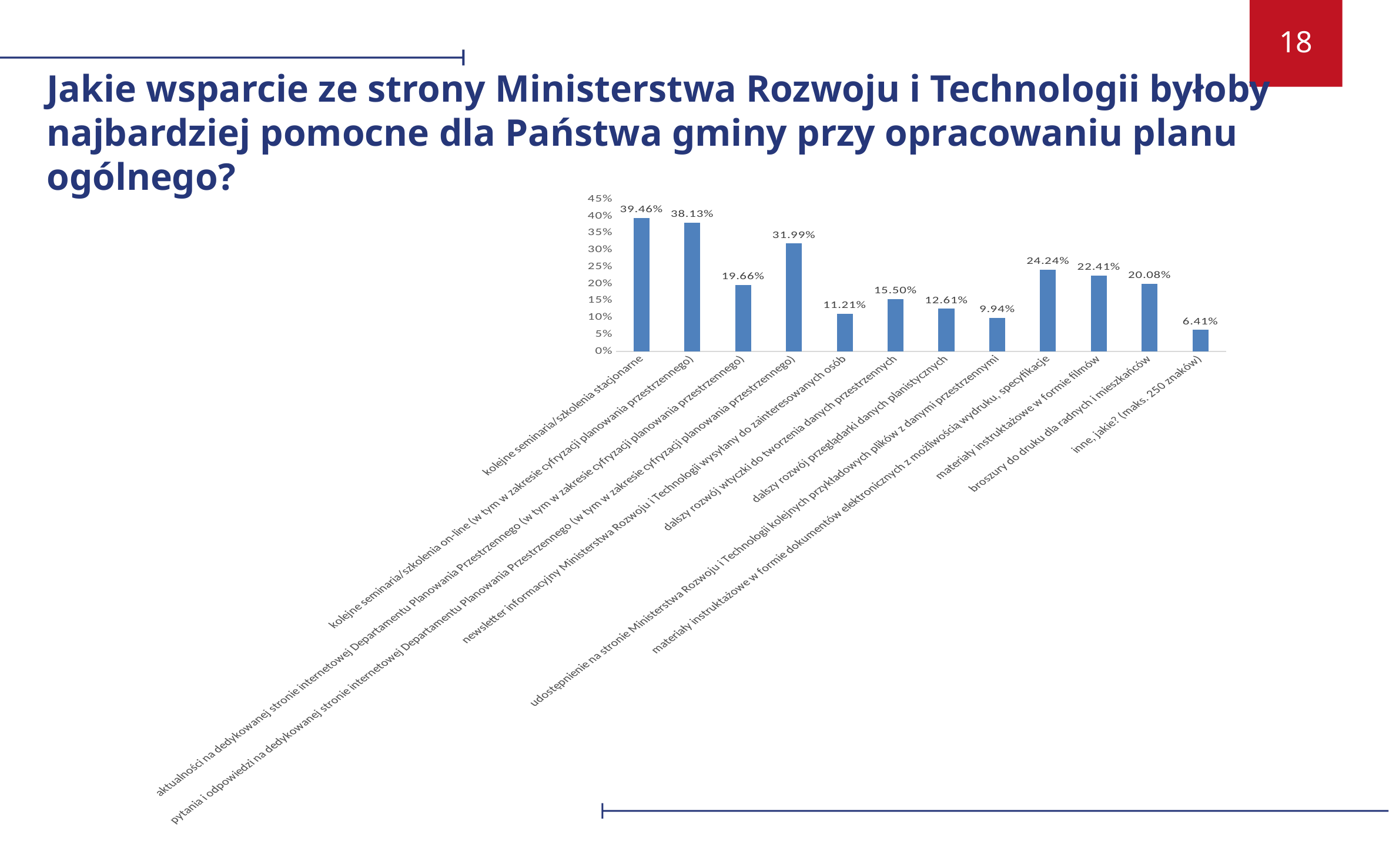
Is the value for 'newsletter informacyjny Ministerstwa Rozwoju i Technologii wysyłany do zainteresowanych osób' greater or less than 15%? less What value is shown for 'broszury do druku dla radnych i mieszkańców'? 20.08% Which is larger: the value for 'materiały instruktażowe w formie filmów' or for 'dalszy rozwój przeglądarki danych planistycznych'? materiały instruktażowe w formie filmów What percentage is shown for 'dalszy rozwój wtyczki do tworzenia danych przestrzennych'? 15.50% What percentage is shown for 'kolejne seminaria/szkolenia stacjonarne'? 39.46% What value is shown for 'materiały instruktażowe w formie filmów'? 22.41% Which category has the highest value in the chart? kolejne seminaria/szkolenia stacjonarne Which category has the lowest value in the chart? inne, jakie? (maks. 250 znaków) What is the difference between the values for 'kolejne seminaria/szkolenia stacjonarne' and 'kolejne seminaria/szkolenia on-line'? 1.33% How many categories (bars) are shown in the chart? 12 What type of chart is shown on the slide? bar chart What is the maximum value shown on the vertical axis of the chart? 45%